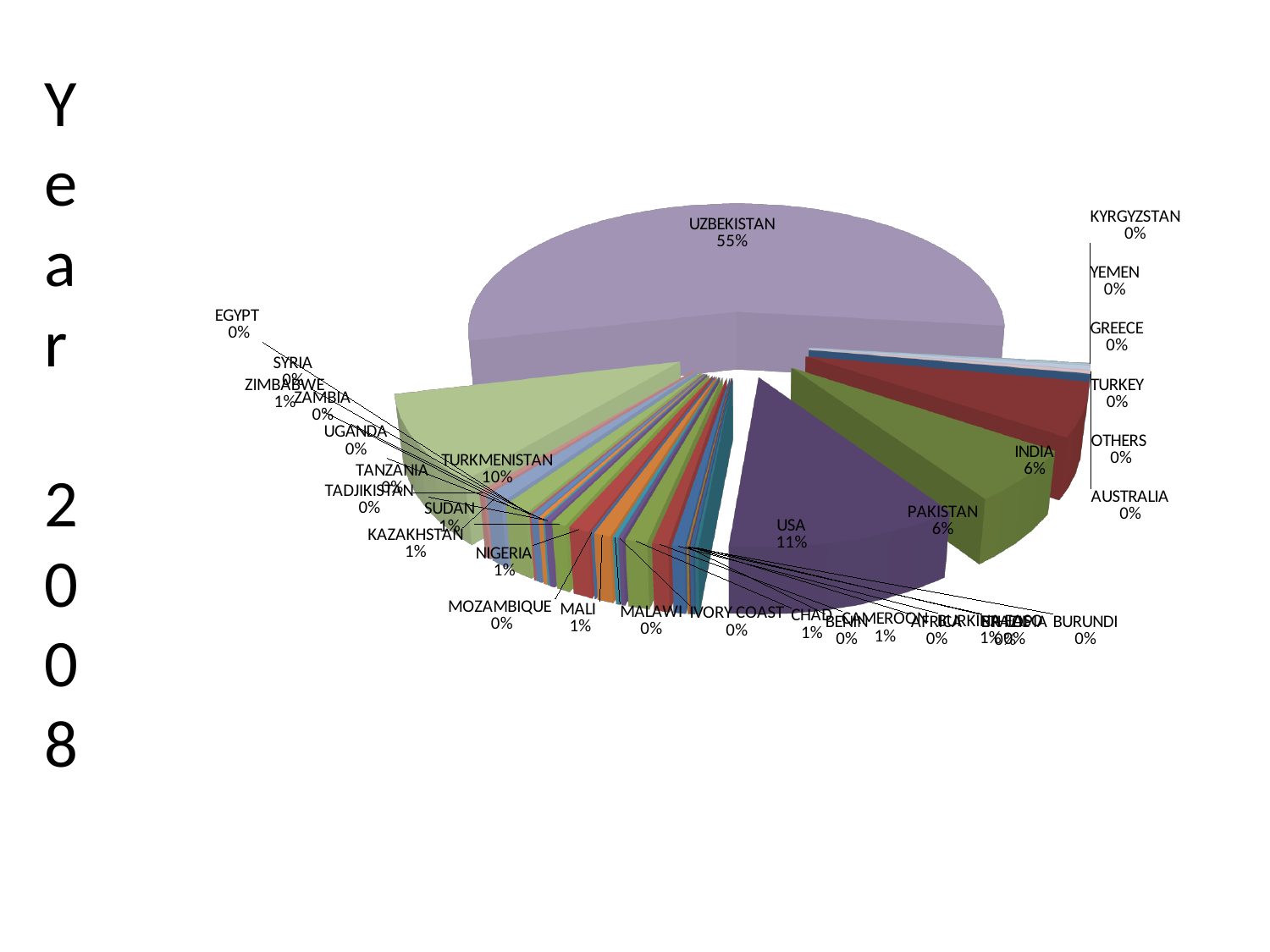
Which year does the slide say the chart refers to? 2008 What is the value shown for INDIA? 6% What is the difference between the shares of UZBEKISTAN and USA? 44% What is the value shown for PAKISTAN? 6% What is the value shown for KAZAKHSTAN? 1% What is the value shown for EGYPT? 0% What share of the pie does UZBEKISTAN hold? 55% Which country has the largest slice of the pie? UZBEKISTAN What is the value shown for TURKMENISTAN? 10% What kind of chart is shown on the slide? Pie chart What is the value shown for USA? 11% Which is larger, the share for USA or the share for TURKMENISTAN? USA